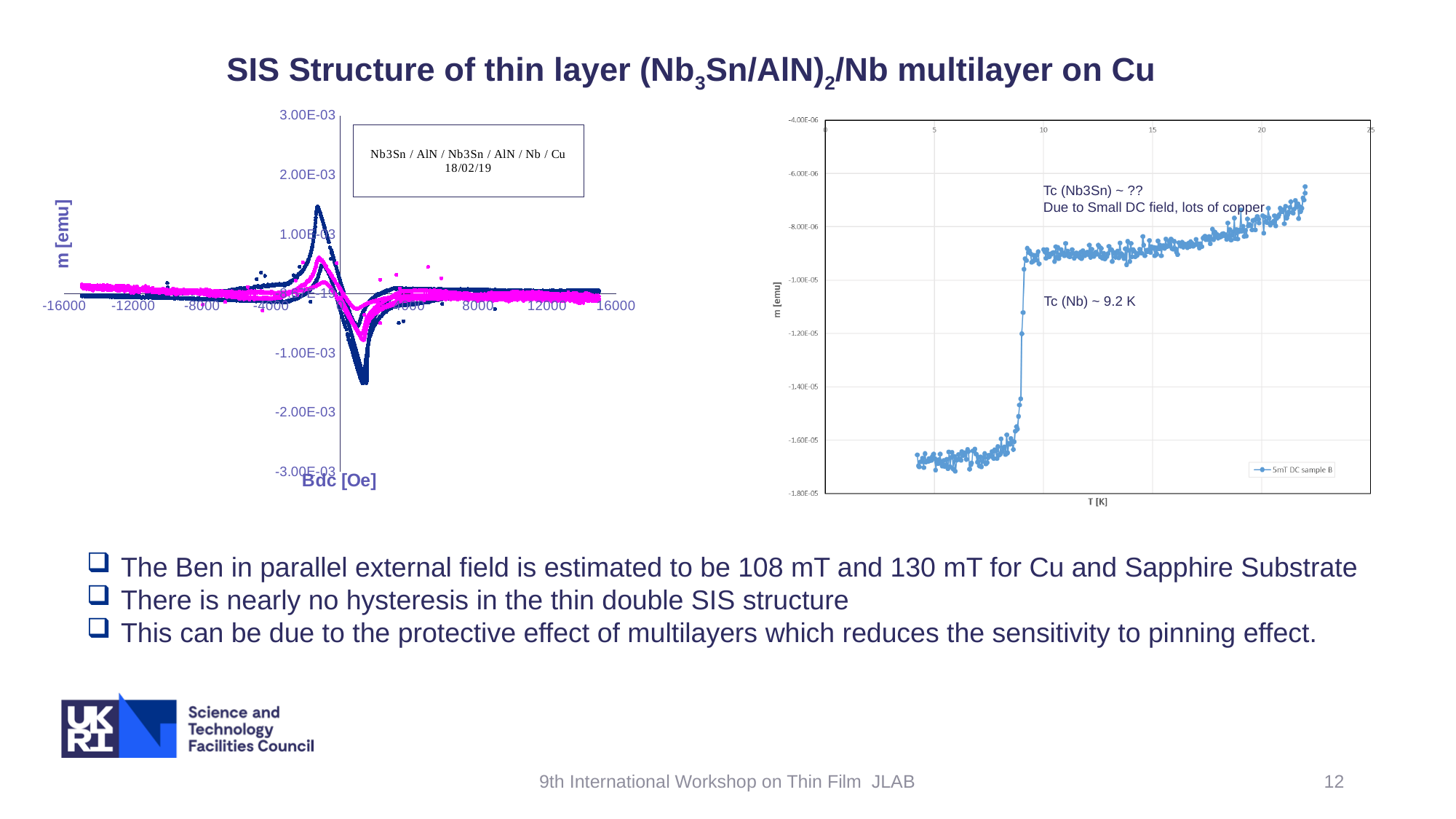
On the right-hand chart, is the value at 20 K greater or less than -1.00E-05? greater On the right-hand chart, do the values rise or fall as temperature increases along the x axis? rise On the right-hand chart, is the value at 15 K greater or less than -1.00E-05? greater What date is shown in the annotation box on the left-hand chart? 18/02/19 What type of chart is the right-hand chart (m [emu] versus T [K])? scatter chart How many series does the legend of the right-hand chart list? 1 What is the legend entry on the right-hand chart? 5mT DC sample B On the right-hand chart, is the value at 5 K greater or less than -1.60E-05? less According to the annotation on the right-hand chart, what is Tc (Nb)? ~ 9.2 K What is the x-axis label of the left-hand chart? Bdc [Oe] What sample structure is written in the annotation box on the left-hand chart? Nb3Sn / AlN / Nb3Sn / AlN / Nb / Cu What type of chart is the left-hand chart (m [emu] versus Bdc [Oe])? scatter chart